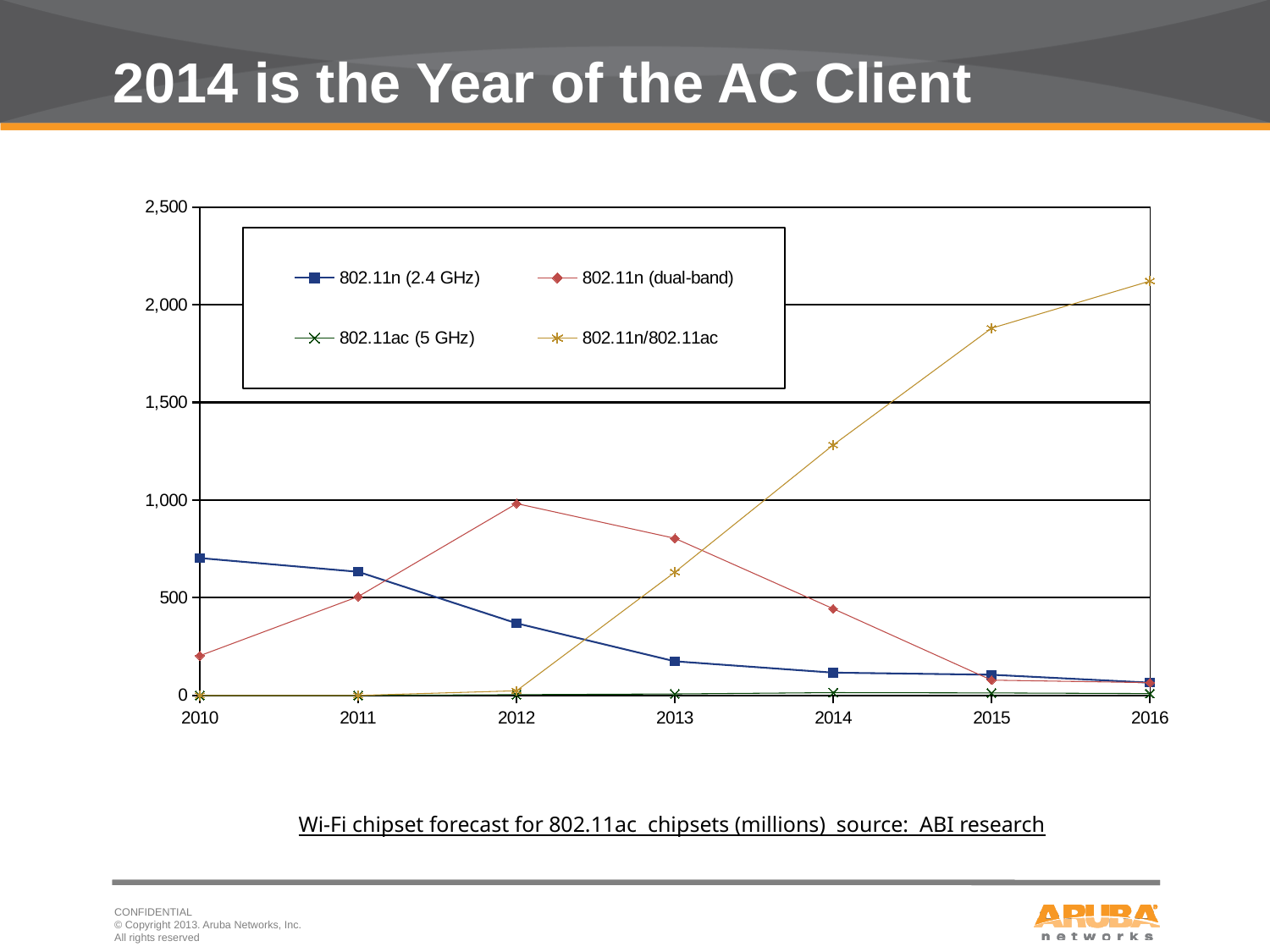
How many years are plotted along the x axis? 7 Is the value for 802.11n/802.11ac in 2014 greater or less than 1,000? greater Is the value for 802.11n (dual-band) in 2014 greater or less than 500? less What is the title of the slide containing the chart? 2014 is the Year of the AC Client Is the value for 802.11n (2.4 GHz) in 2010 greater or less than 500? greater Which series has the highest value in 2016? 802.11n/802.11ac What kind of chart is shown on the slide? line chart In 2013, which is larger: 802.11n (dual-band) or 802.11n (2.4 GHz)? 802.11n (dual-band) In which year does the 802.11n (dual-band) series reach its peak? 2012 Does the 802.11n (2.4 GHz) series rise or fall from 2010 to 2016? fall How many series does the legend list? 4